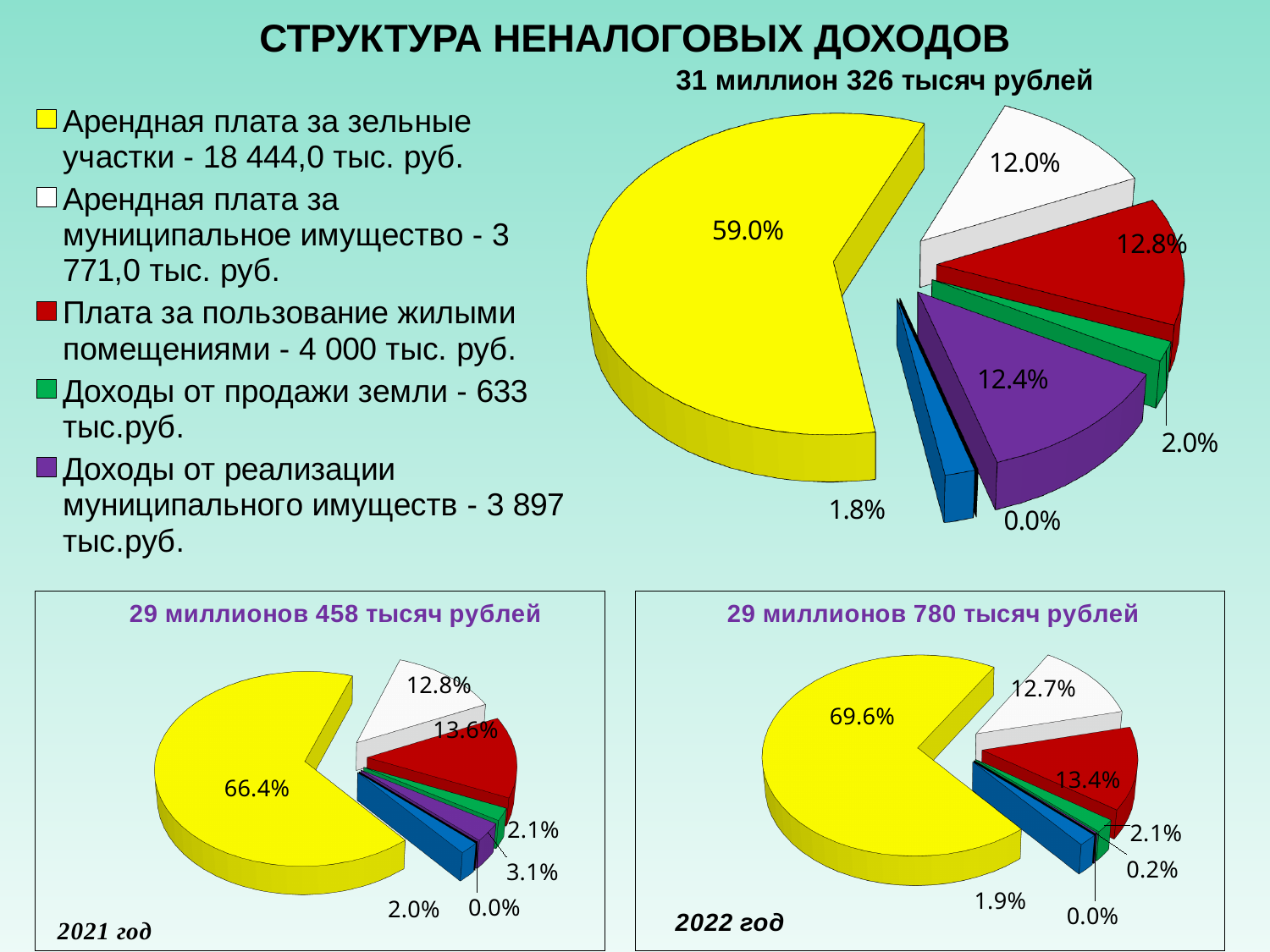
In the top chart titled '31 миллион 326 тысяч рублей', what share does the purple slice (Доходы от реализации муниципального имущества) have? 12.4% In the bottom-right chart for 2022 год, what share does the yellow slice have? 69.6% In the top chart titled '31 миллион 326 тысяч рублей', what is the difference between the red slice (12.8%) and the white slice (12.0%)? 0.8% In the top chart titled '31 миллион 326 тысяч рублей', what share does the yellow slice (Арендная плата за земельные участки) have? 59.0% How many pie charts are shown on the slide? 3 Which is larger: the yellow slice in the 2021 год chart or the yellow slice in the 2022 год chart? 2022 год What kind of chart is used on this slide? Pie chart In the top chart titled '31 миллион 326 тысяч рублей', which category has the largest share? Арендная плата за зельные участки